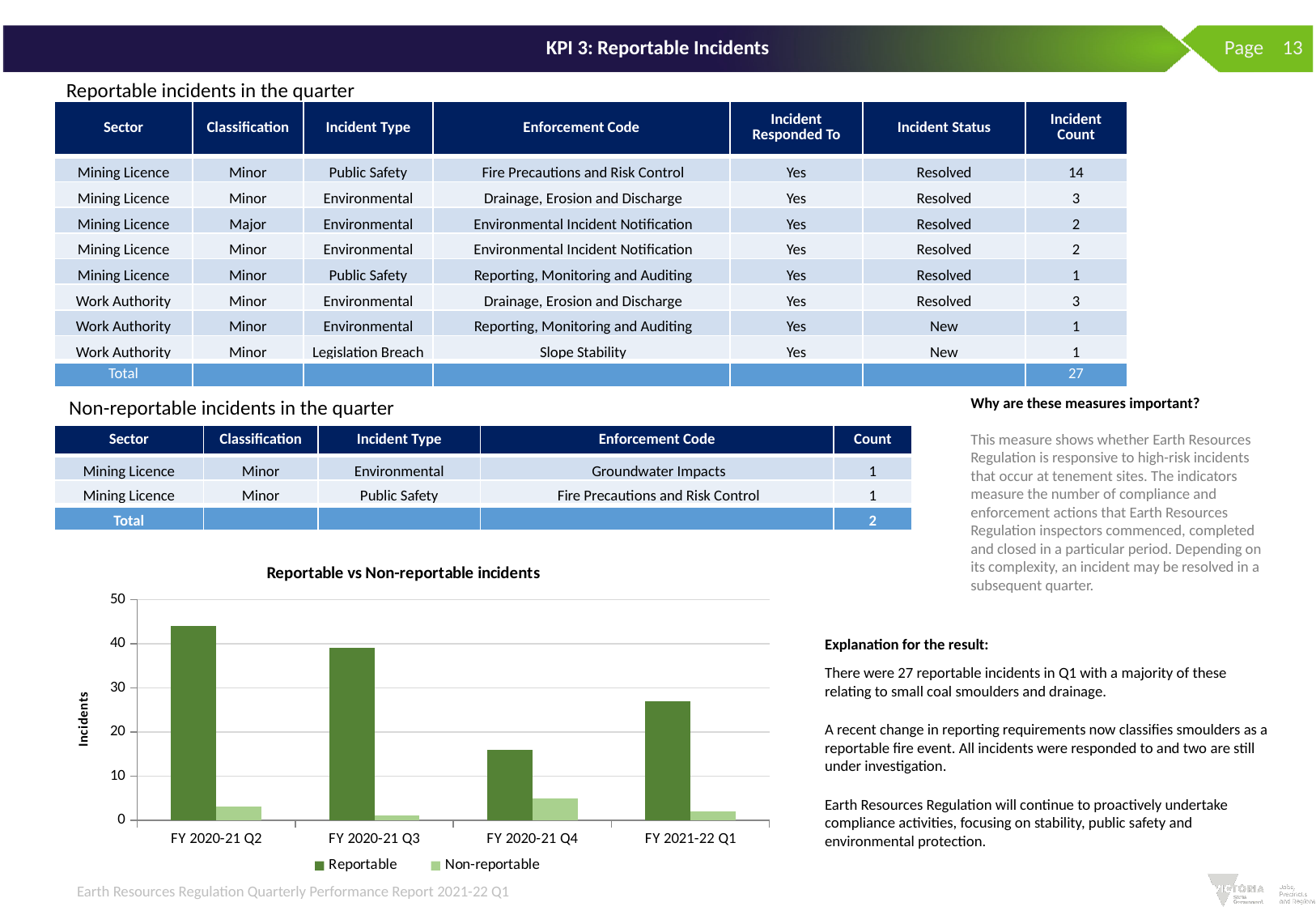
Which quarter has the highest Reportable value in the chart? FY 2020-21 Q2 Is the Reportable value for FY 2020-21 Q4 greater or less than 20? less Which quarter has the highest Non-reportable value in the chart? FY 2020-21 Q4 Which quarter has the lowest Reportable value in the chart? FY 2020-21 Q4 How many series does the chart's legend list? 2 Do the Reportable values rise or fall from FY 2020-21 Q2 to FY 2020-21 Q4? fall What is the title of the chart on the slide? Reportable vs Non-reportable incidents How many quarters are shown on the x axis of the chart? 4 Which is larger in the chart: the Reportable value for FY 2020-21 Q3 or for FY 2021-22 Q1? FY 2020-21 Q3 Is the Reportable value for FY 2021-22 Q1 greater or less than 30? less Is the Reportable value for FY 2020-21 Q2 greater or less than 40? greater What kind of chart is shown on the slide? bar chart